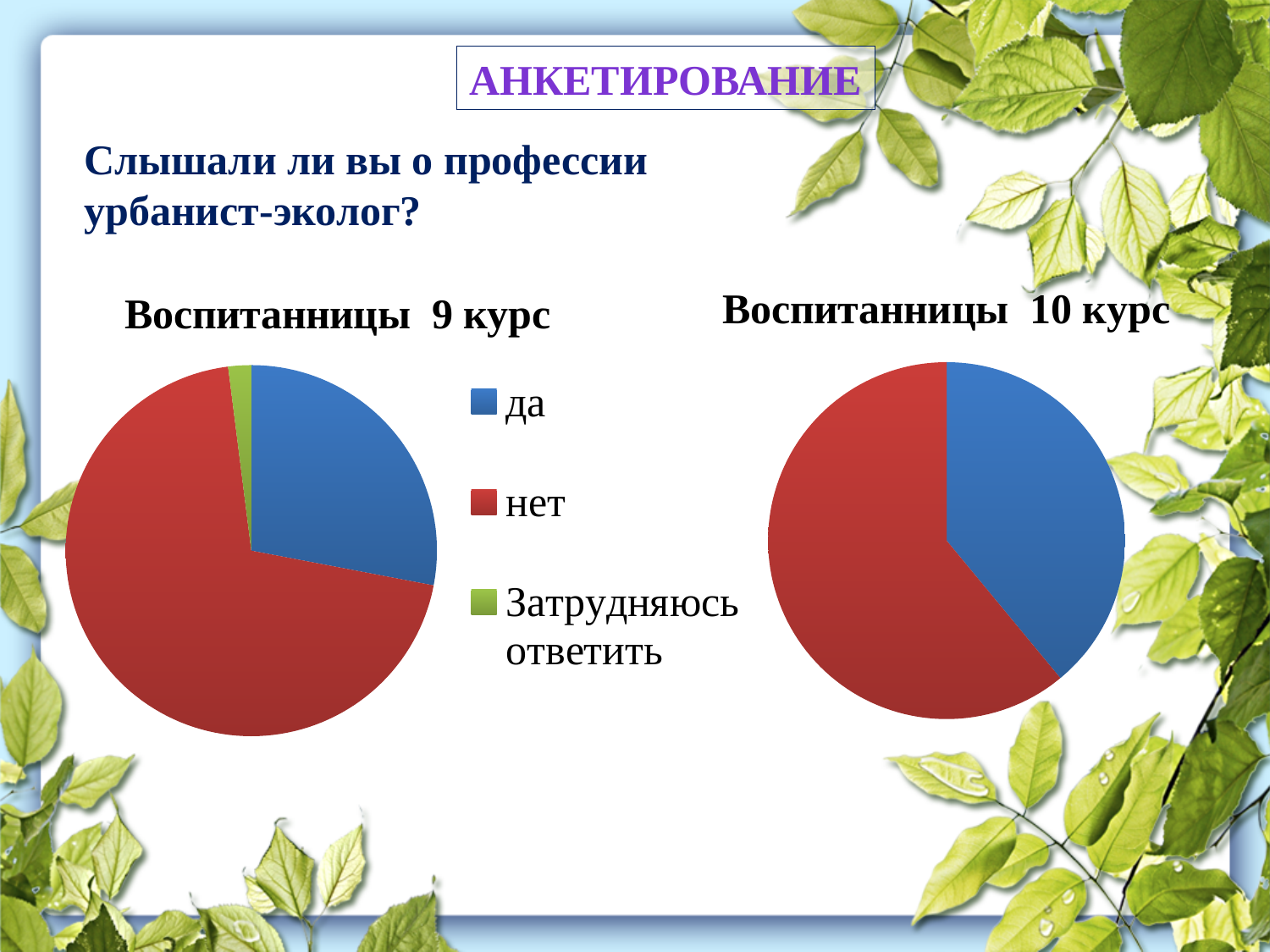
What kind of chart is the chart titled "Воспитанницы 9 курс"? pie chart What kind of chart is the chart titled "Воспитанницы 10 курс"? pie chart In the chart titled "Воспитанницы 9 курс", which category has the largest slice? нет What is the title of the pie chart on the right side of the slide? Воспитанницы 10 курс How many slices does the chart titled "Воспитанницы 9 курс" have? 3 In the chart titled "Воспитанницы 9 курс", which slice is larger, "да" or "нет"? нет In the chart titled "Воспитанницы 9 курс", which slice is larger, "да" or "Затрудняюсь ответить"? да In the chart titled "Воспитанницы 9 курс", which category has the smallest slice? Затрудняюсь ответить How many slices does the chart titled "Воспитанницы 10 курс" have? 2 In the chart titled "Воспитанницы 9 курс", what colour is the slice for "да"? blue How many entries does the legend of the chart titled "Воспитанницы 9 курс" list? 3 In the chart titled "Воспитанницы 10 курс", which slice is larger, the blue one or the red one? the red one